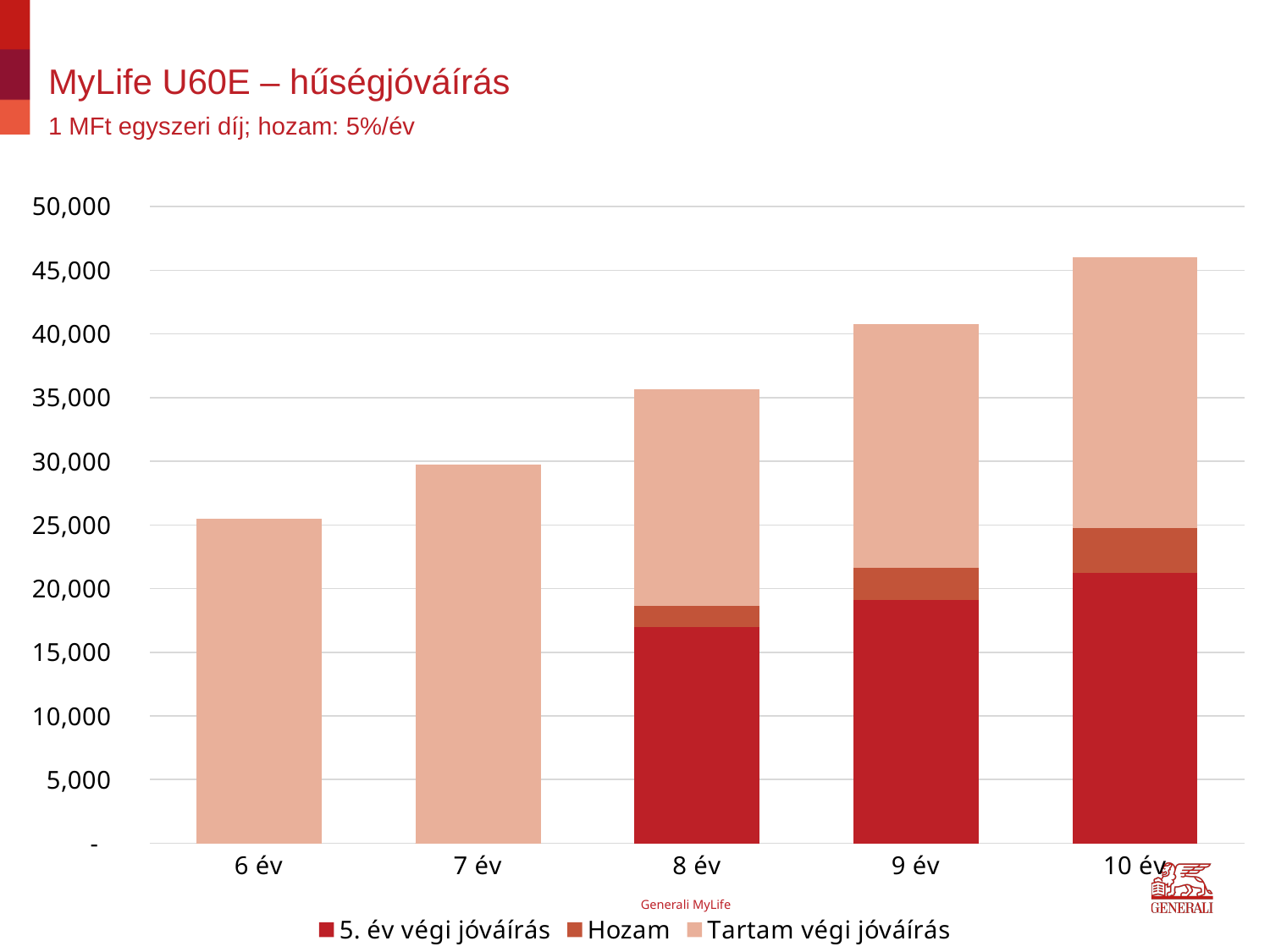
Which category has the highest total bar? 10 év Do the total bar heights rise or fall from 6 év to 10 év? Rise What kind of chart is shown on the slide? Stacked bar chart Is the '5. év végi jóváírás' value for 10 év greater or less than 20,000? greater Which category has the lowest total bar? 6 év Which is larger, the total bar for 7 év or the total bar for 9 év? 9 év Is the total value for 10 év greater or less than 45,000? greater How many categories are shown on the x axis? 5 What is the title of the chart slide? MyLife U60E – hűségjóváírás Is the total value for 8 év greater or less than 40,000? less How many series does the legend list? 3